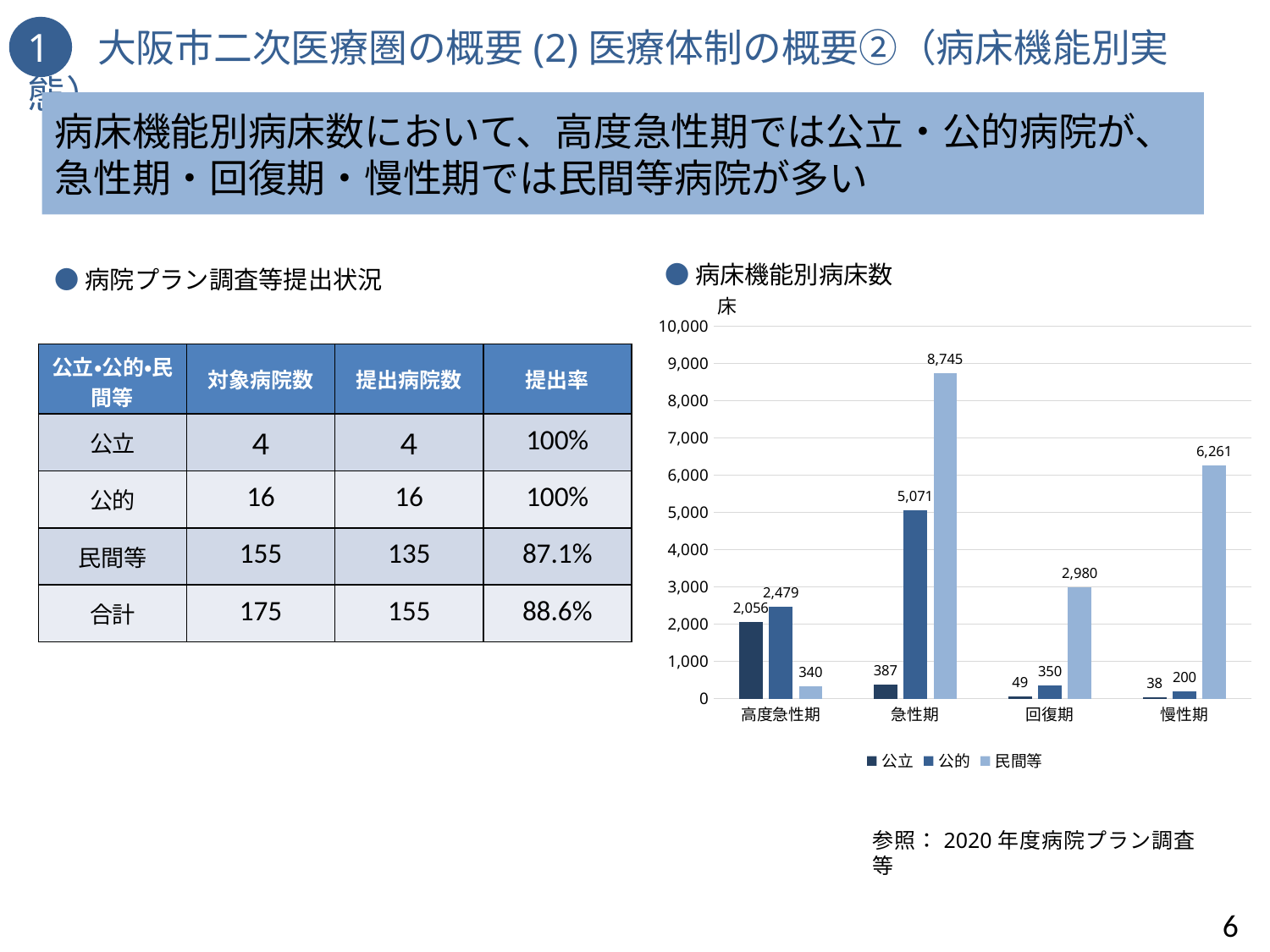
How many series does the chart's legend list? 3 What is the value for 民間等 in the 急性期 category? 8,745 What is the difference between the 民間等 value and the 公的 value in the 急性期 category? 3,674 What is the value for 民間等 in the 慢性期 category? 6,261 What is the value for 公的 in the 回復期 category? 350 Which is larger in the 高度急性期 category, the value for 公立 or the value for 公的? 公的 What kind of chart is shown on the slide? bar chart What is the value for 公立 in the 高度急性期 category? 2,056 In which category does 民間等 have its highest value? 急性期 What is the total of the three series in the 回復期 category? 3,379 In which category does 公立 have its lowest value? 慢性期 How many categories are shown on the x axis of the chart? 4